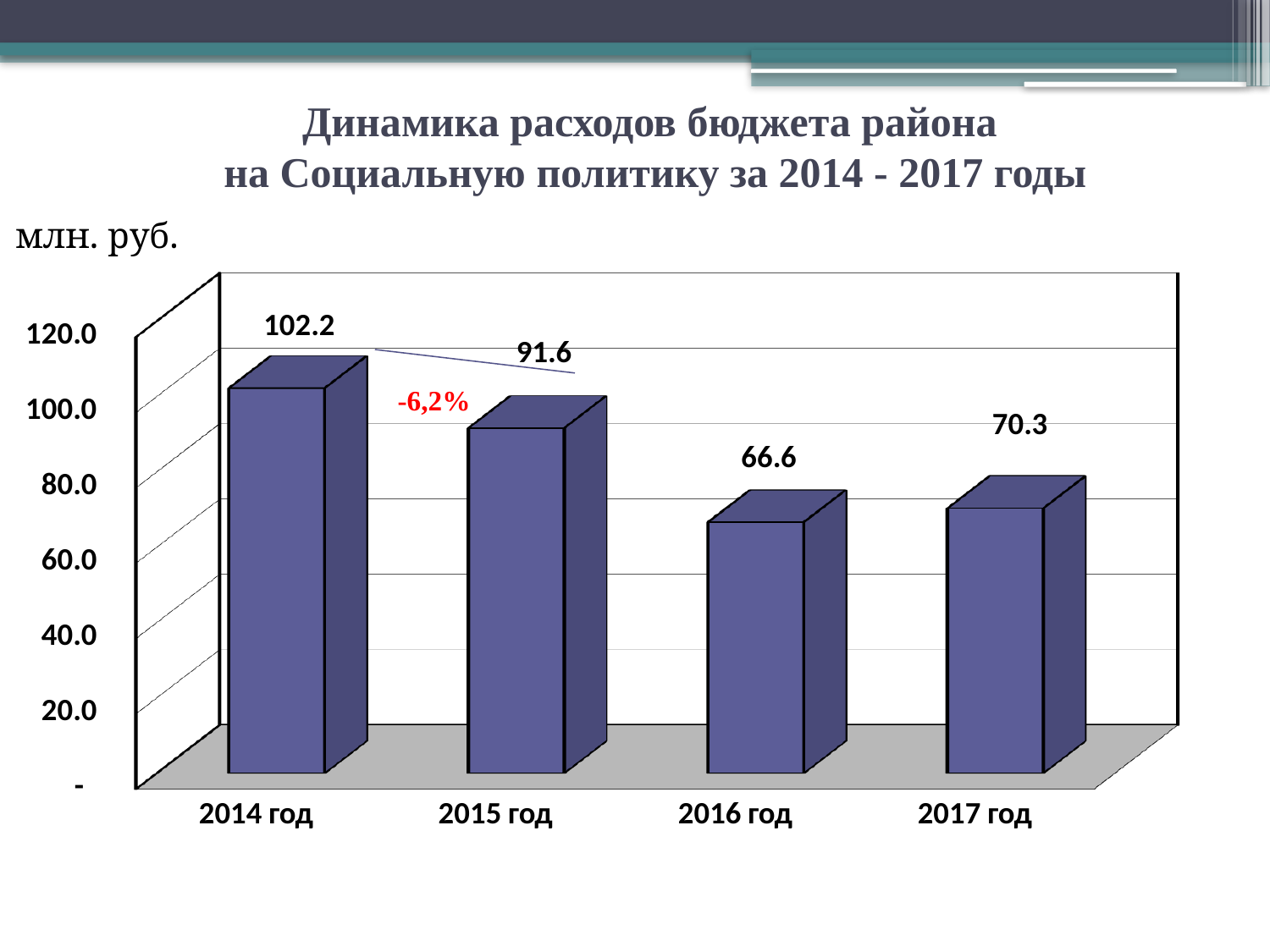
Which is larger, the value for 2015 год or the value for 2017 год? 2015 год Is the value for 2016 год greater or less than 80.0? less What kind of chart is shown on the slide? bar chart What is the value for 2016 год? 66.6 Which year has the lowest value? 2016 год What is the difference between the values for 2017 год and 2016 год? 3.7 What is the value for 2017 год? 70.3 Which year has the highest value? 2014 год How many years are shown on the x axis? 4 What percentage change is annotated in red between 2014 год and 2015 год? -6,2% What is the value for 2014 год? 102.2 What is the difference between the values for 2014 год and 2015 год? 10.6